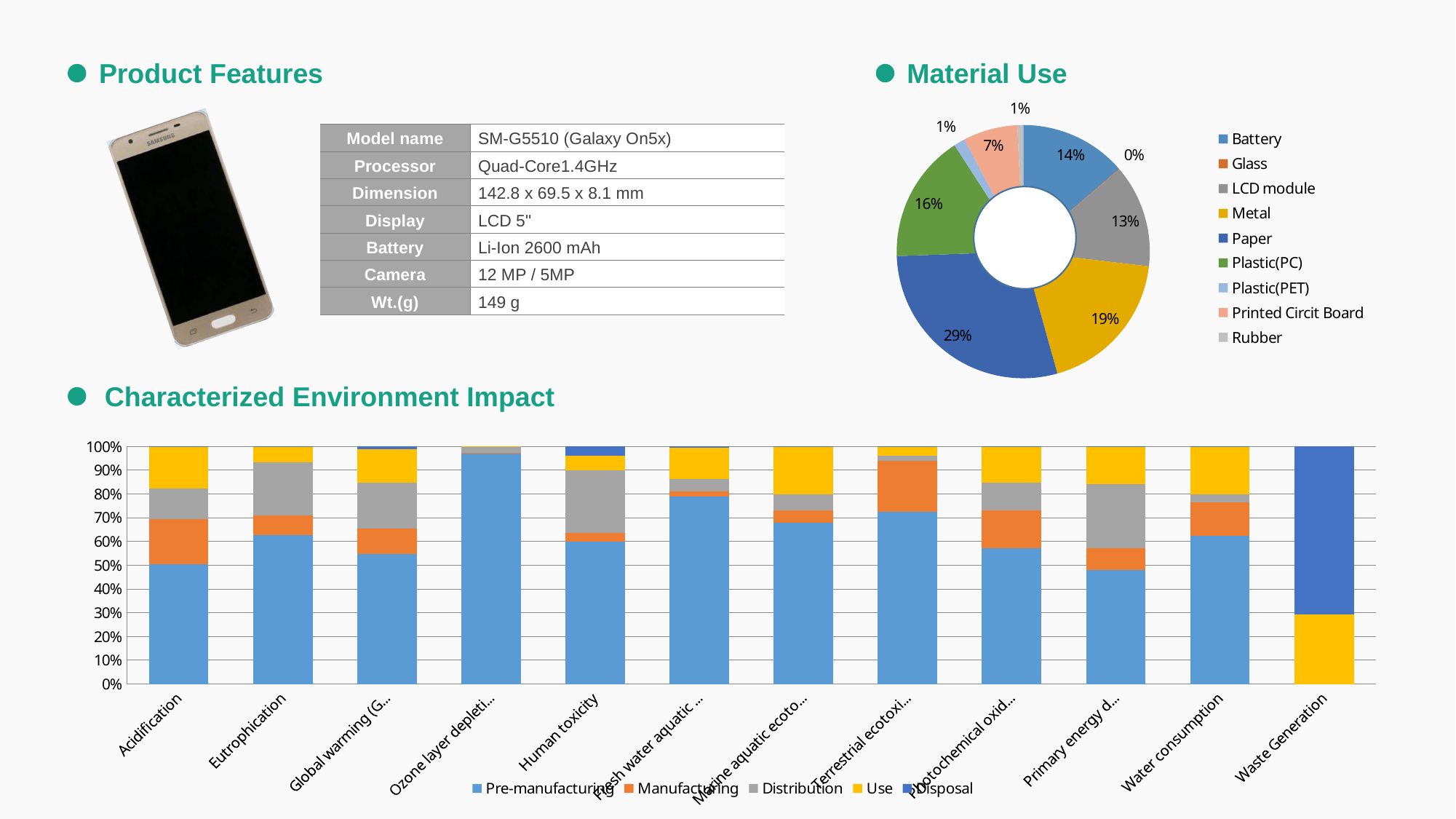
In the Characterized Environment Impact chart, how many series does the legend list? 5 In the Material Use chart, what percentage is Paper? 29% In the Characterized Environment Impact chart, which category has the largest Pre-manufacturing share? Ozone layer depletion In the Material Use chart, which is larger, Plastic(PC) or LCD module? Plastic(PC) In the Material Use chart, which material has the largest share? Paper In the Characterized Environment Impact chart, is the Pre-manufacturing share for Ozone layer depletion greater or less than 90%? greater What kind of chart is the Characterized Environment Impact chart? Stacked bar chart In the Material Use chart, how many percentage points larger is Paper than Battery? 15 percentage points In the Material Use chart, what percentage is Glass? 0% In the Characterized Environment Impact chart, how many impact categories are shown on the x axis? 12 In the Material Use chart, how many materials does the legend list? 9 In the Material Use chart, what percentage is Metal? 19%